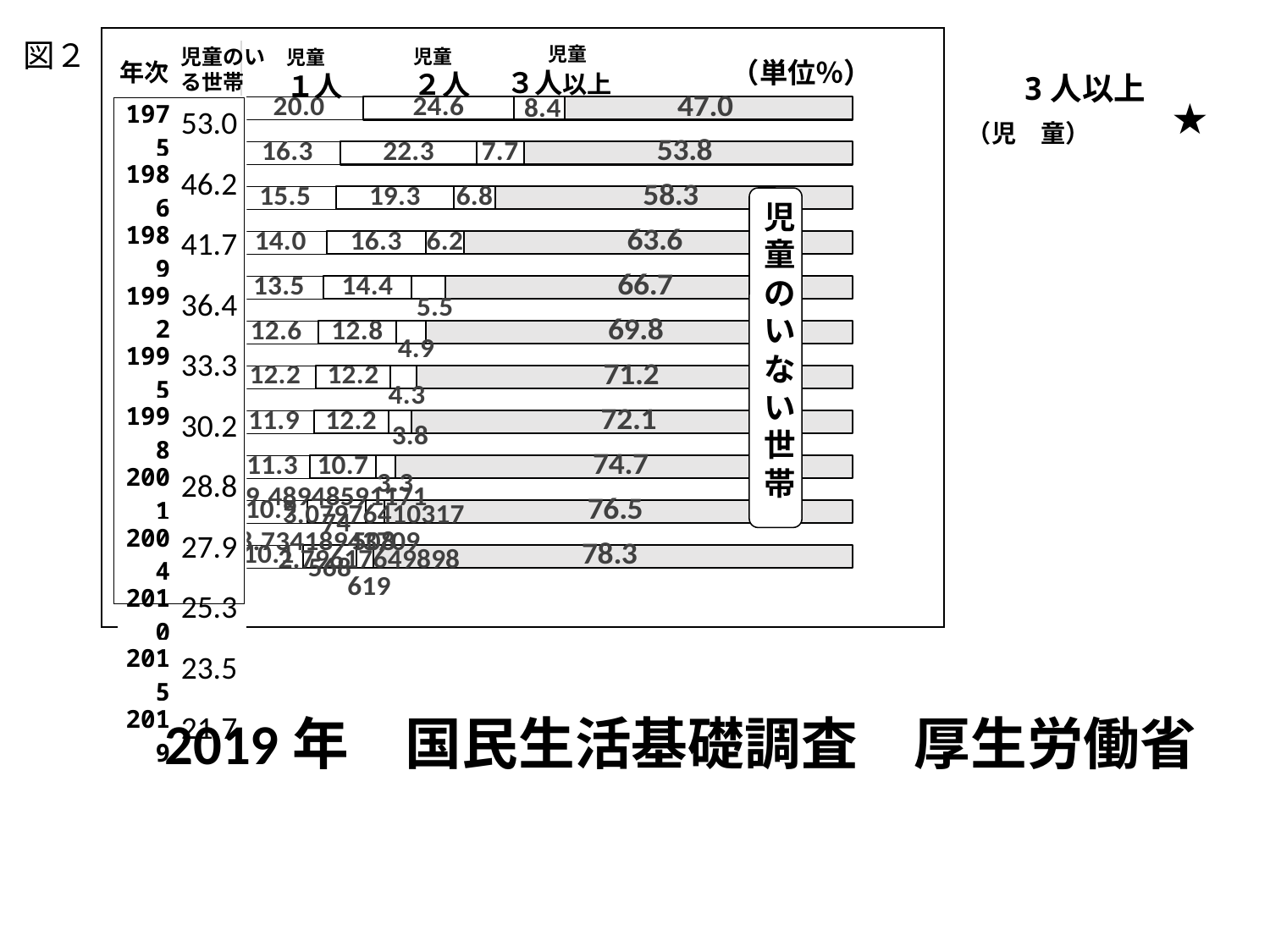
Which bar has the highest value for 児童のいない世帯? The bottom bar What kind of chart is shown on the slide? Stacked horizontal bar chart In the top bar (1975), which is larger: 児童1人 or 児童2人? 児童2人 In the bottom bar, what is the value for 児童のいない世帯? 78.3 In the top bar (1975), what is the difference between 児童2人 and 児童3人以上? 16.2 Going from the top bar to the bottom bar, do the values for 児童のいない世帯 rise or fall? Rise How many series (household categories) are shown in each bar? 4 How many bars (rows) does the chart contain? 11 In the top bar (1975), what is the value for 児童のいない世帯? 47.0 What unit is indicated for the values in the chart? % In the top bar (1975), what is the value for 児童1人? 20.0 In the second bar from the top, what is the value for 児童のいない世帯? 53.8